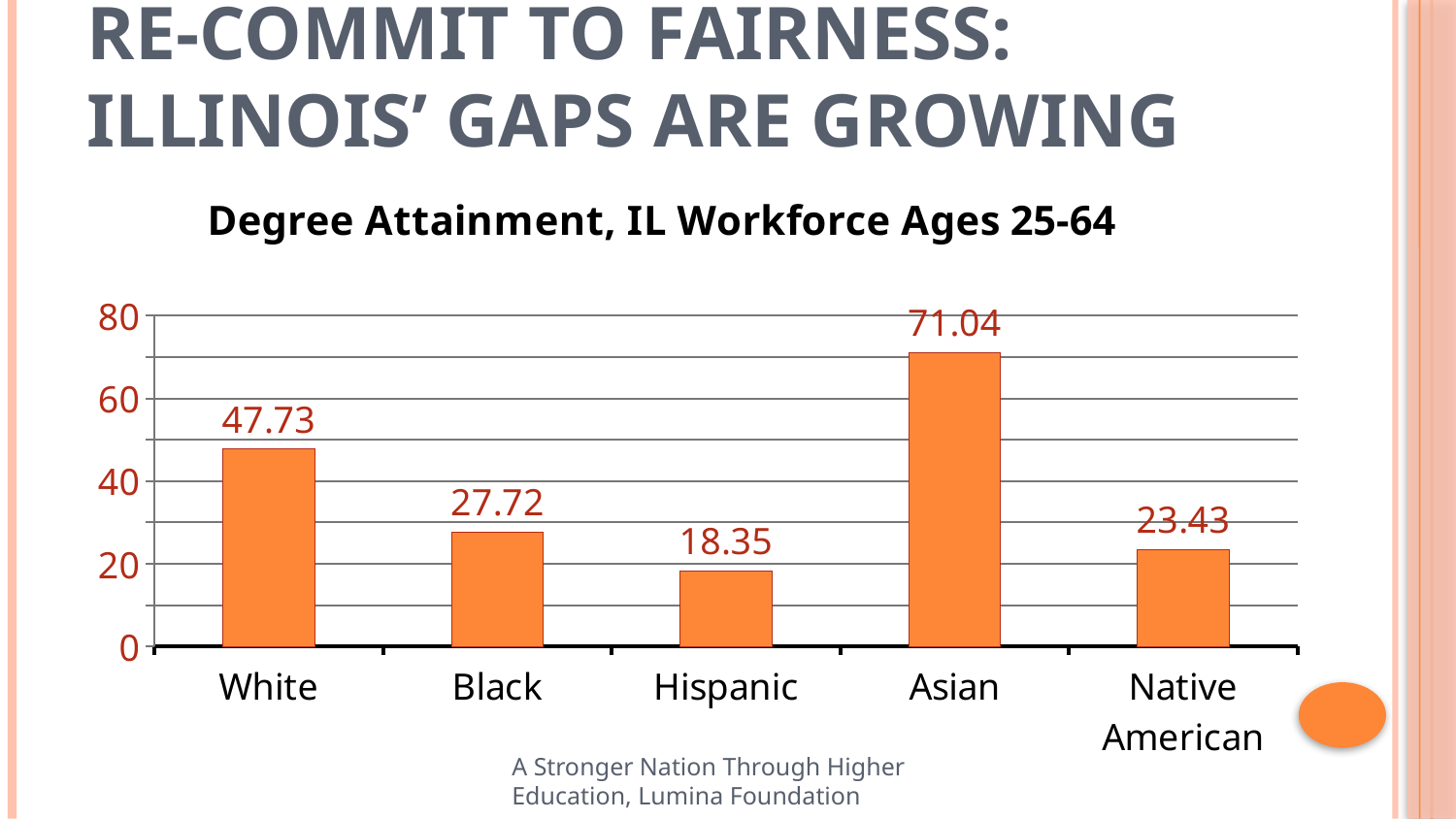
What is the degree attainment value for Native American? 23.43 Which is larger, the value for Black or the value for Native American? Black Which category has the lowest degree attainment? Hispanic What is the title of the chart? Degree Attainment, IL Workforce Ages 25-64 Is the value for Asian greater or less than 60? greater What kind of chart is shown on the slide? bar chart Which category has the highest degree attainment? Asian How many categories are shown on the x axis? 5 What is the difference between the values for Asian and White? 23.31 What is the difference between the values for Black and Native American? 4.29 What is the degree attainment value for White? 47.73 What is the degree attainment value for Hispanic? 18.35